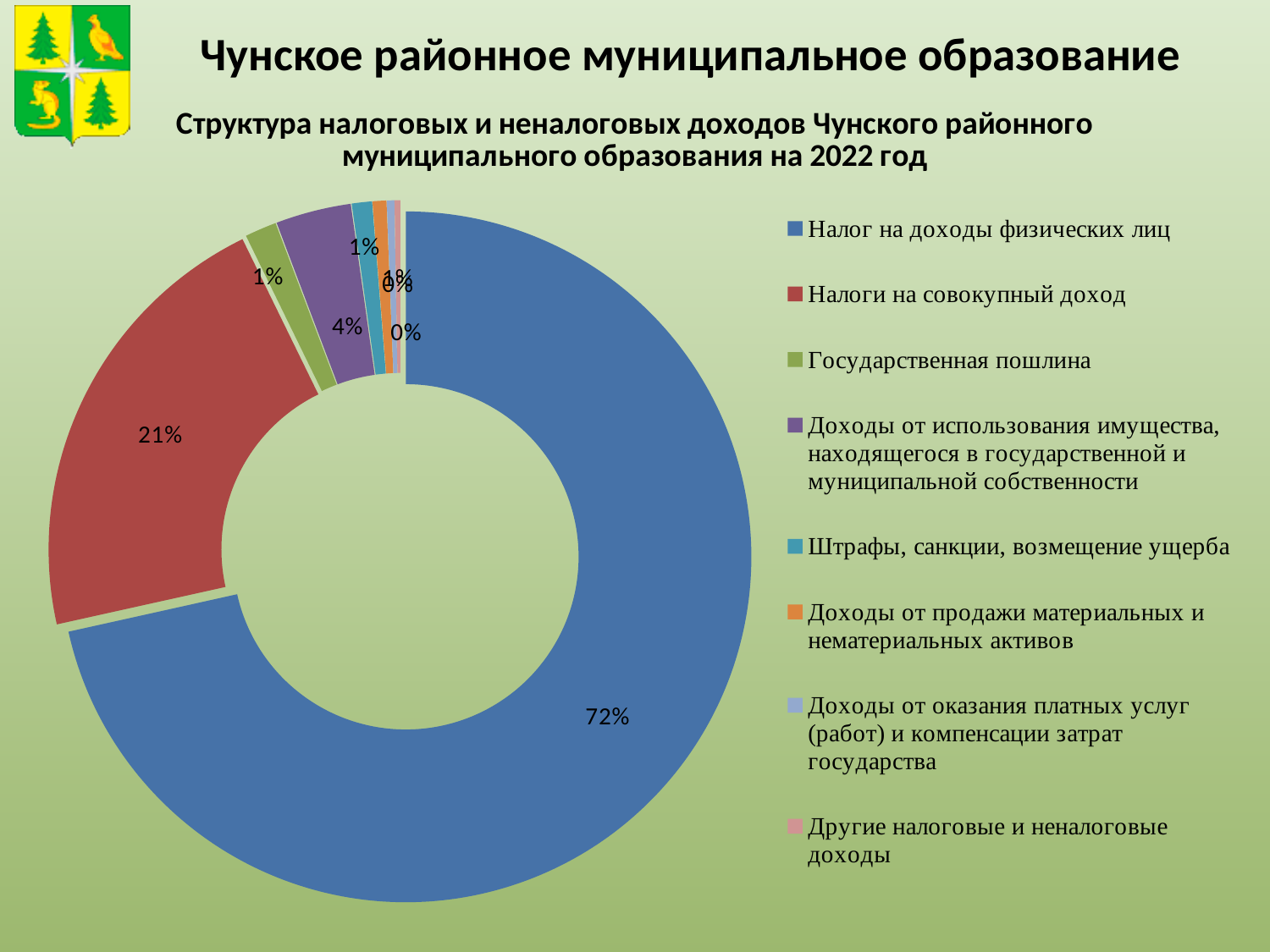
What year does the chart title refer to? 2022 What share of revenues does "Государственная пошлина" account for? 1% What is the difference in percentage points between "Налог на доходы физических лиц" and "Налоги на совокупный доход"? 51 How many categories does the legend list? 8 Which is larger: the share of "Налоги на совокупный доход" or the share of "Доходы от использования имущества, находящегося в государственной и муниципальной собственности"? Налоги на совокупный доход What share of revenues does "Доходы от использования имущества, находящегося в государственной и муниципальной собственности" account for? 4% What share of revenues does "Налоги на совокупный доход" account for? 21% What share of revenues does "Налог на доходы физических лиц" account for? 72% What colour represents "Налоги на совокупный доход" in the chart? Red What kind of chart is shown on the slide? Doughnut (pie) chart What share of revenues does "Штрафы, санкции, возмещение ущерба" account for? 1% Which category has the largest share of revenues? Налог на доходы физических лиц